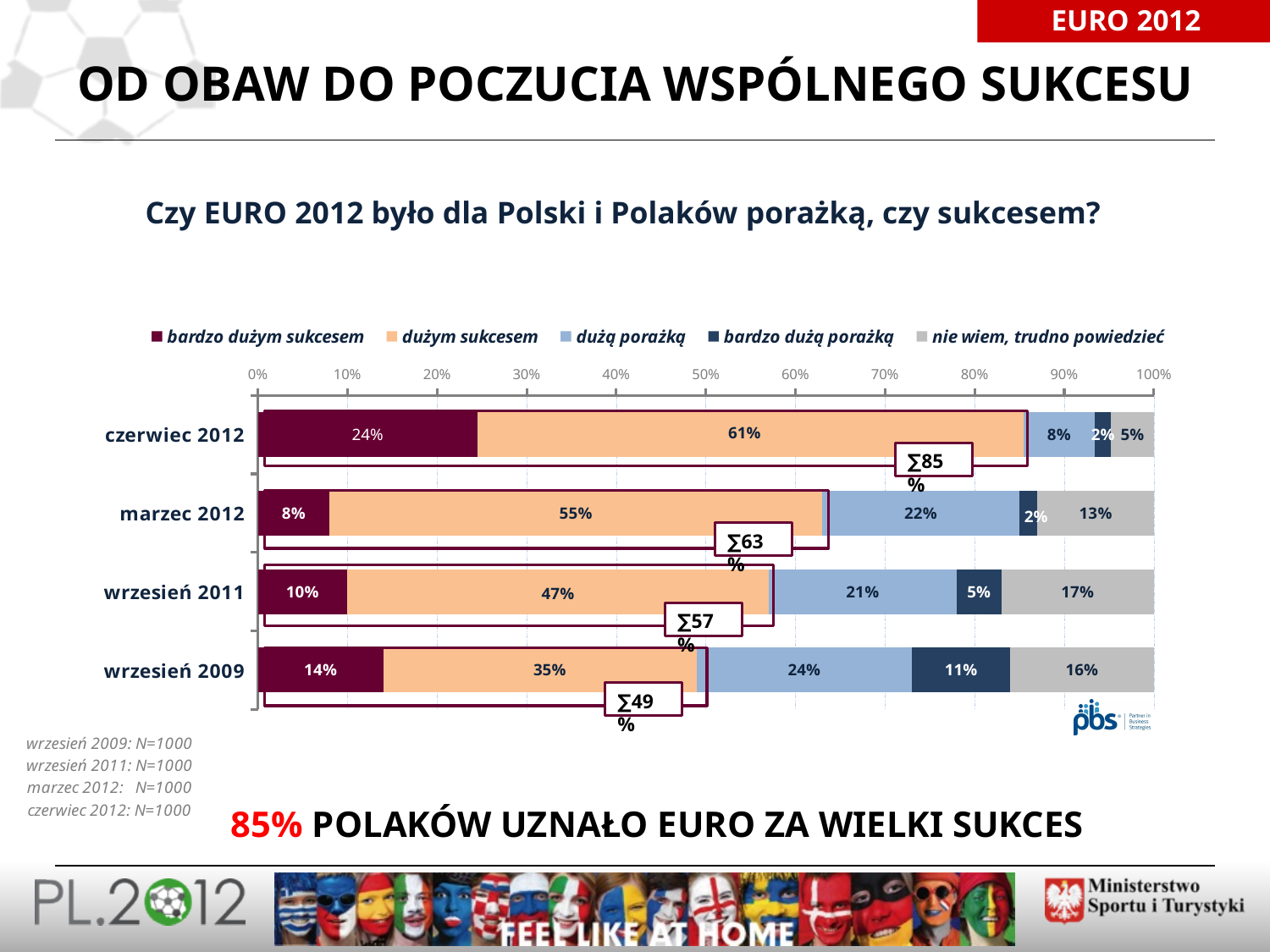
Which survey wave has the lowest value for "dużym sukcesem"? wrzesień 2009 Which survey wave has the highest value for "bardzo dużym sukcesem"? czerwiec 2012 What is the value for "bardzo dużą porażką" in wrzesień 2009? 11% Which is larger: the "bardzo dużym sukcesem" value for wrzesień 2009 or for marzec 2012? wrzesień 2009 How many series does the legend list? 5 What is the combined share of "bardzo dużym sukcesem" and "dużym sukcesem" for wrzesień 2011, as labelled on the chart? ∑57% What is the difference between the "dużą porażką" values for wrzesień 2009 and czerwiec 2012? 16% What is the value for "dużym sukcesem" in czerwiec 2012? 61% What kind of chart is shown on the slide? stacked bar chart How does the "bardzo dużą porażką" value change from wrzesień 2009 to czerwiec 2012? it falls How many survey waves (categories) are shown on the chart? 4 What is the value for "nie wiem, trudno powiedzieć" in marzec 2012? 13%